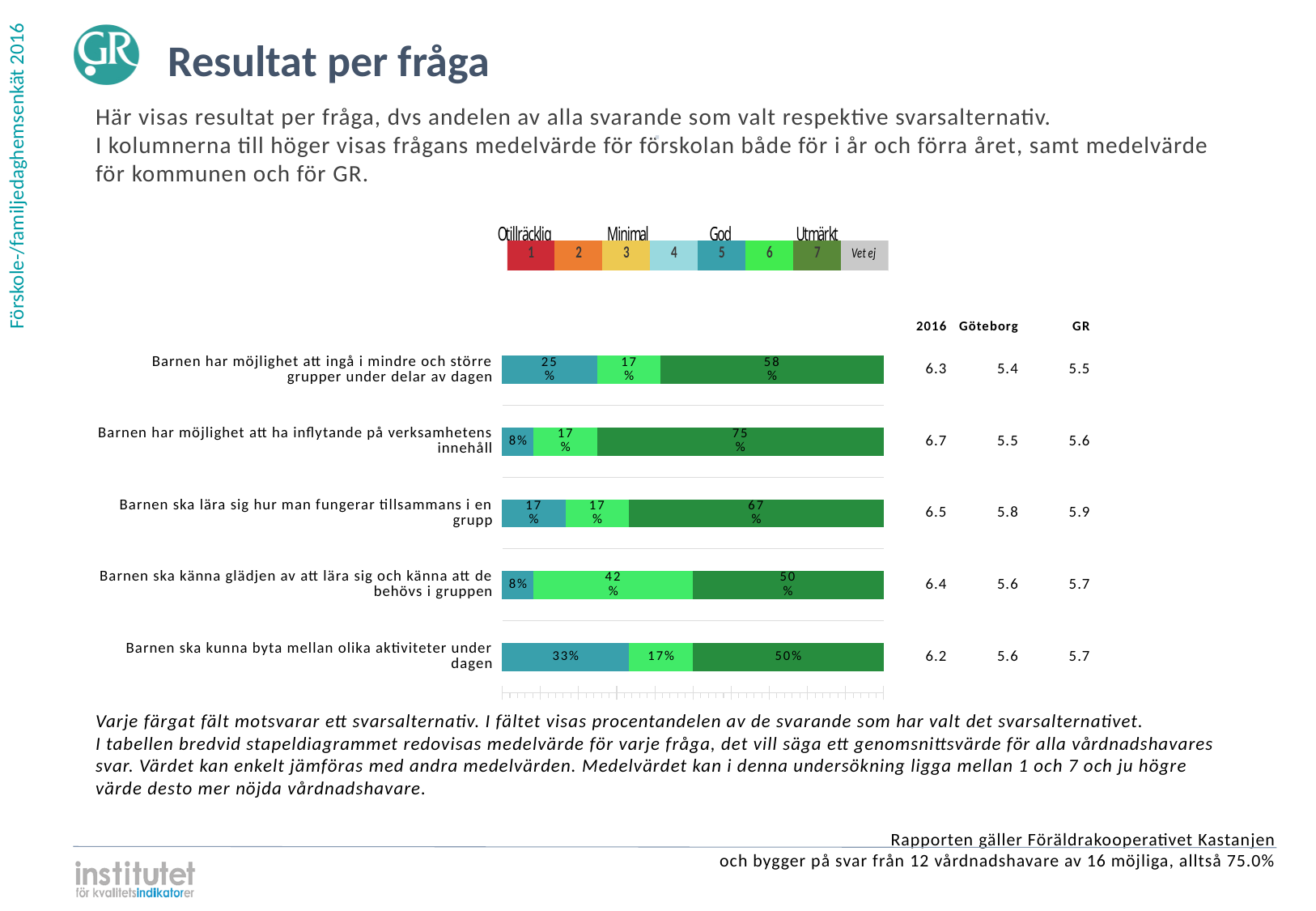
What is the GR mean value for "Barnen ska lära sig hur man fungerar tillsammans i en grupp"? 5.9 Which is larger: the answer 5 share for "Barnen ska kunna byta mellan olika aktiviteter under dagen" or for "Barnen har möjlighet att ingå i mindre och större grupper under delar av dagen"? Barnen ska kunna byta mellan olika aktiviteter under dagen What percentage of respondents chose answer 7 (dark green) for "Barnen har möjlighet att ha inflytande på verksamhetens innehåll"? 75% Which question has the smallest share of respondents choosing answer 7 (dark green)? Barnen ska känna glädjen av att lära sig och känna att de behövs i gruppen and Barnen ska kunna byta mellan olika aktiviteter under dagen (both 50%) How many questions (categories) are shown in the bar chart? 5 What is the 2016 mean value for "Barnen har möjlighet att ha inflytande på verksamhetens innehåll"? 6.7 What is the difference between the answer 7 share for "Barnen har möjlighet att ha inflytande på verksamhetens innehåll" and for "Barnen ska kunna byta mellan olika aktiviteter under dagen"? 25% What kind of chart is used to show the results per question? stacked bar chart What percentage of respondents chose answer 5 (teal) for "Barnen ska kunna byta mellan olika aktiviteter under dagen"? 33% Which question has the largest share of respondents choosing answer 7 (dark green)? Barnen har möjlighet att ha inflytande på verksamhetens innehåll How many answer alternatives does the legend above the chart list, including "Vet ej"? 8 What percentage of respondents chose answer 6 (light green) for "Barnen ska känna glädjen av att lära sig och känna att de behövs i gruppen"? 42%